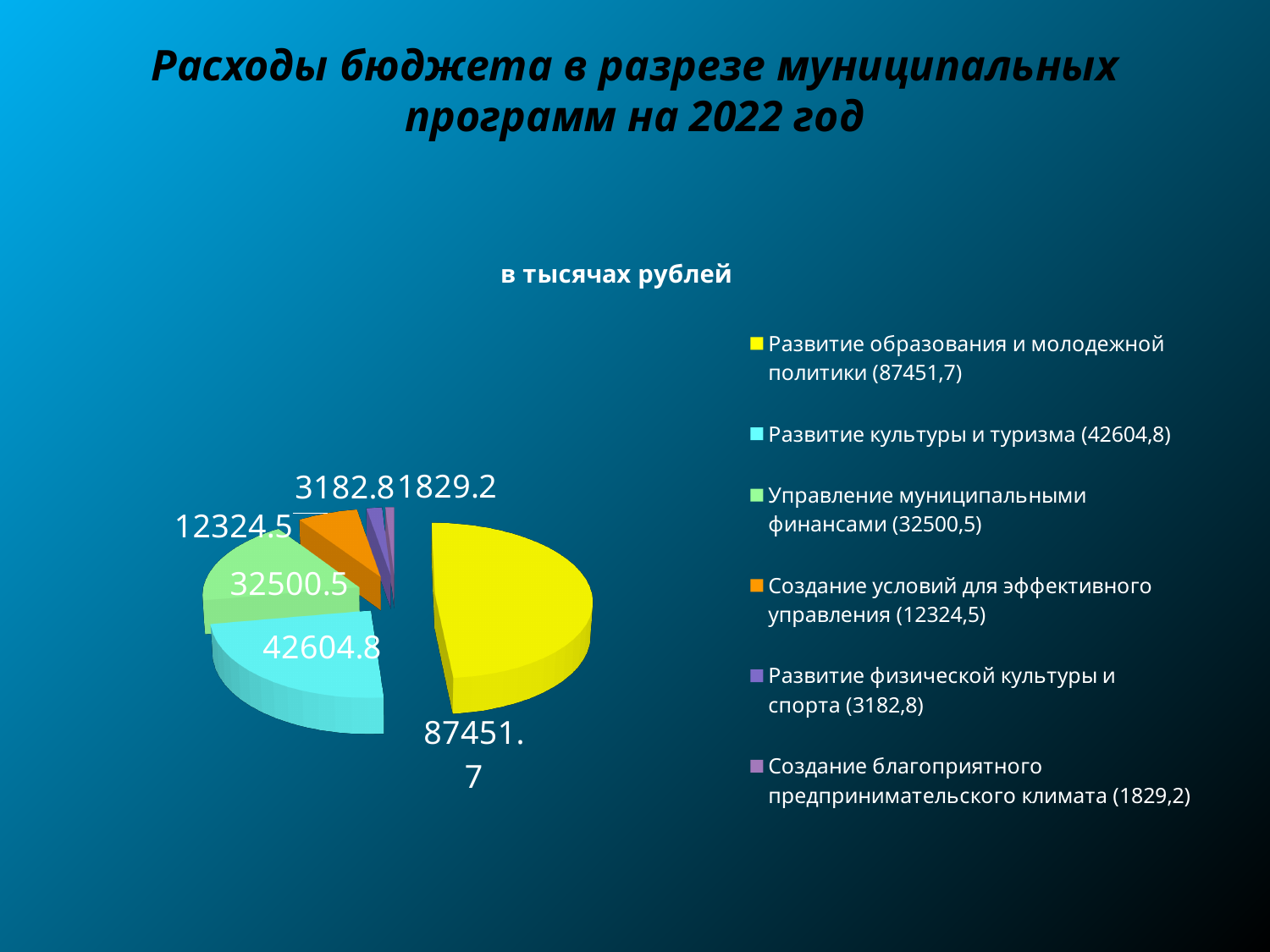
What is the value for «Развитие образования и молодежной политики»? 87451.7 Which program has the smallest share of the budget expenses? Создание благоприятного предпринимательского климата What is the difference between the values for «Развитие образования и молодежной политики» and «Развитие культуры и туризма»? 44846.9 How many entries does the legend list? 6 What is the value for «Развитие культуры и туризма»? 42604.8 What is the value for «Управление муниципальными финансами»? 32500.5 What type of chart is shown on the slide? Pie chart Which program has the largest share of the budget expenses? Развитие образования и молодежной политики Which is larger: the value for «Развитие физической культуры и спорта» or for «Создание благоприятного предпринимательского климата»? Развитие физической культуры и спорта In what units are the values on the chart expressed, according to the chart subtitle? в тысячах рублей What is the value for «Создание благоприятного предпринимательского климата»? 1829.2 How many slices does the pie chart have? 6